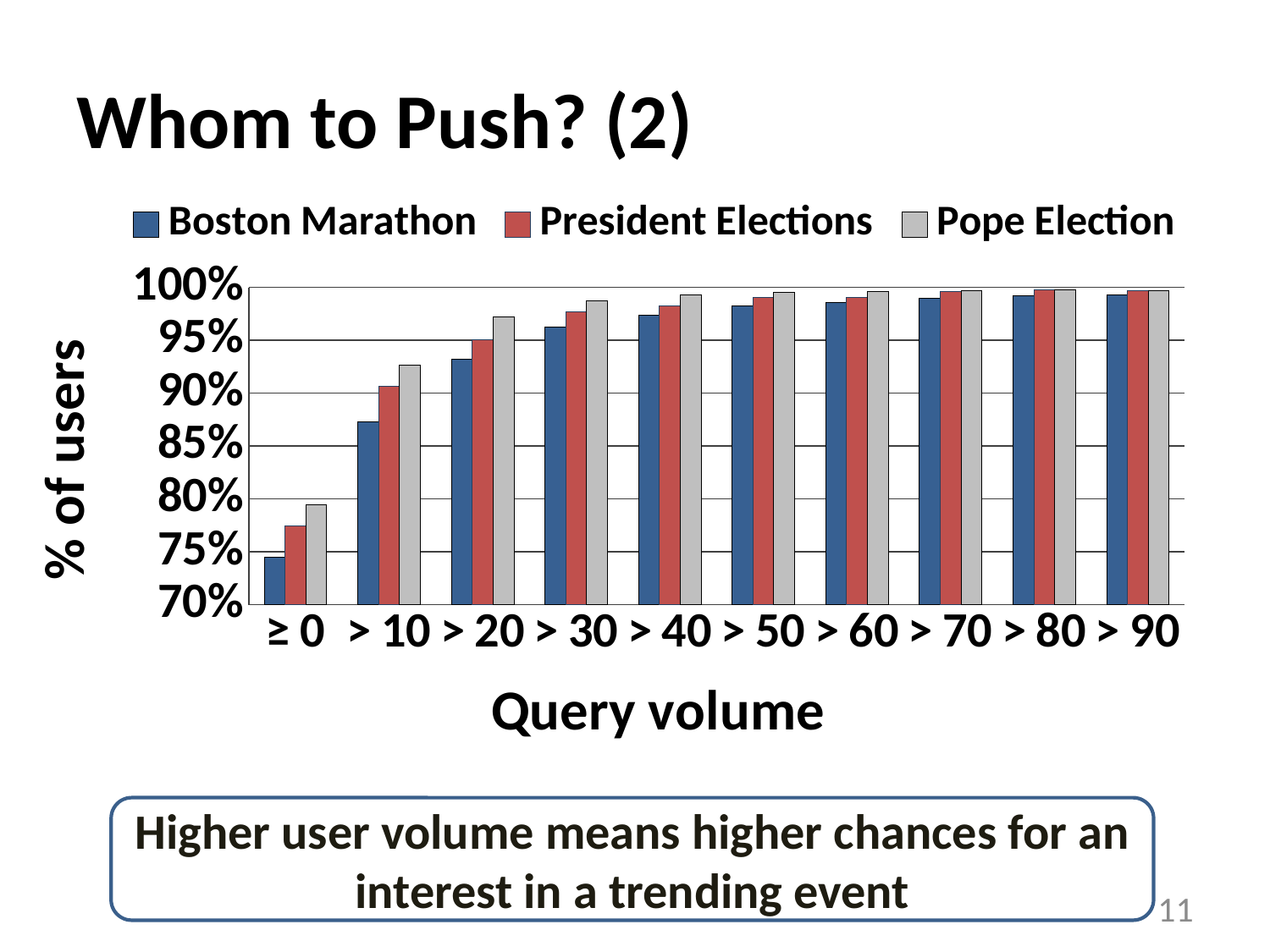
Which series has the lowest value in the "≥ 0" category? Boston Marathon Is the value for Pope Election at "> 20" greater or less than 95%? greater How many series does the legend list? 3 What is the title of the y axis? % of users Which series has the highest value in the "≥ 0" category? Pope Election Is the value for President Elections at "≥ 0" greater or less than 75%? greater What kind of chart is shown on the slide? bar chart Do the Boston Marathon values rise or fall as query volume increases along the x axis? rise Is the value for Boston Marathon at "> 20" greater or less than 95%? less In the "> 10" category, which is larger: Boston Marathon or President Elections? President Elections How many query volume categories are shown on the x axis? 10